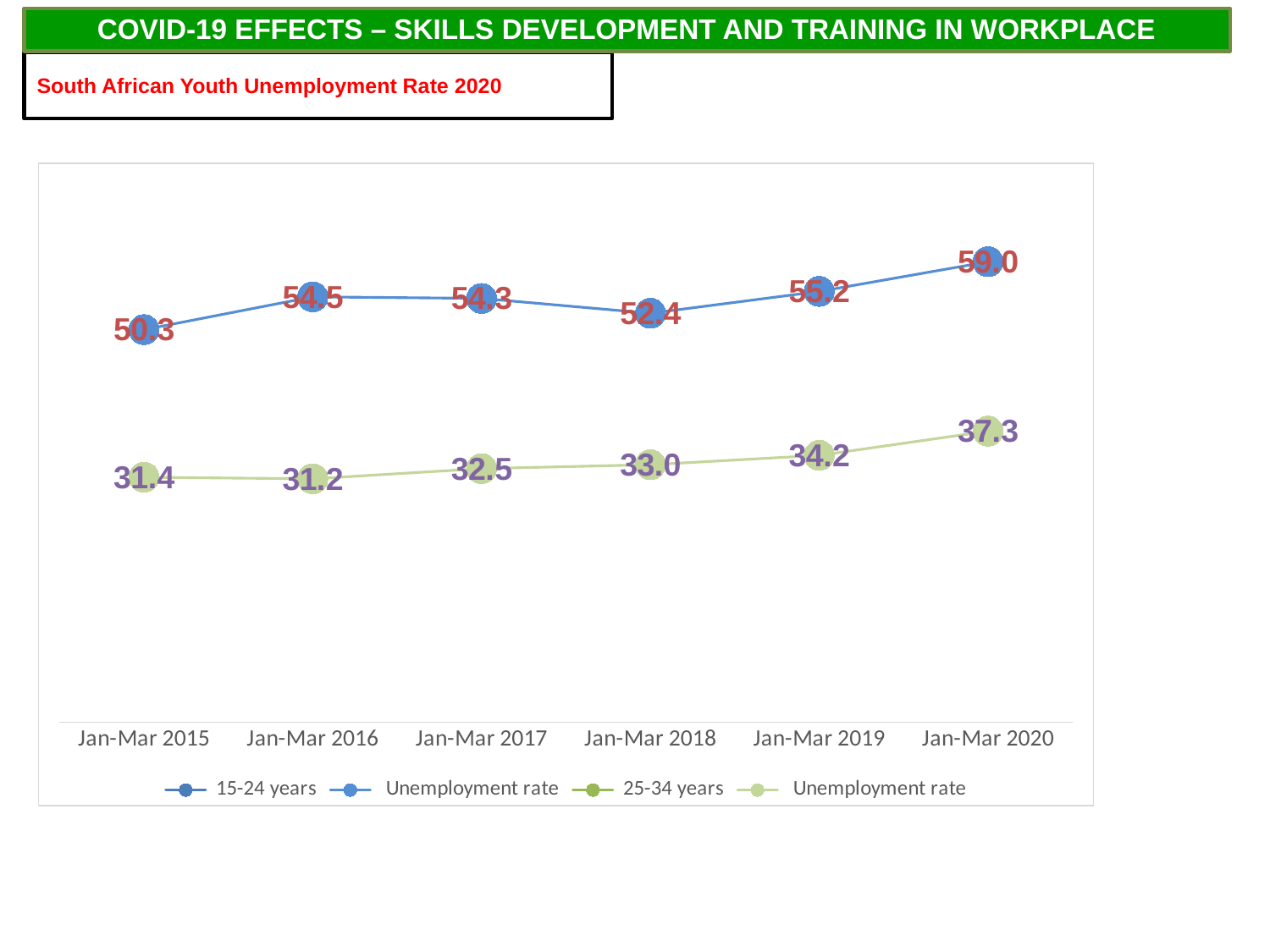
What is the difference between the 15-24 years and 25-34 years values in Jan-Mar 2020? 21.7 How many entries does the legend list? 4 What is the value for the 15-24 years series in Jan-Mar 2018? 52.4 What is the unemployment rate for the 25-34 years series in Jan-Mar 2017? 32.5 By how much did the 15-24 years unemployment rate change from Jan-Mar 2019 to Jan-Mar 2020? 3.8 In which period is the 25-34 years unemployment rate lowest? Jan-Mar 2016 How many time periods are shown on the x axis? 6 What kind of chart is shown on the slide? Line chart What is the unemployment rate for the 15-24 years series in Jan-Mar 2020? 59.0 Does the 25-34 years unemployment rate generally rise or fall from Jan-Mar 2016 to Jan-Mar 2020? Rise Which is larger: the 15-24 years value in Jan-Mar 2016 or in Jan-Mar 2018? Jan-Mar 2016 In which period is the 15-24 years unemployment rate highest? Jan-Mar 2020